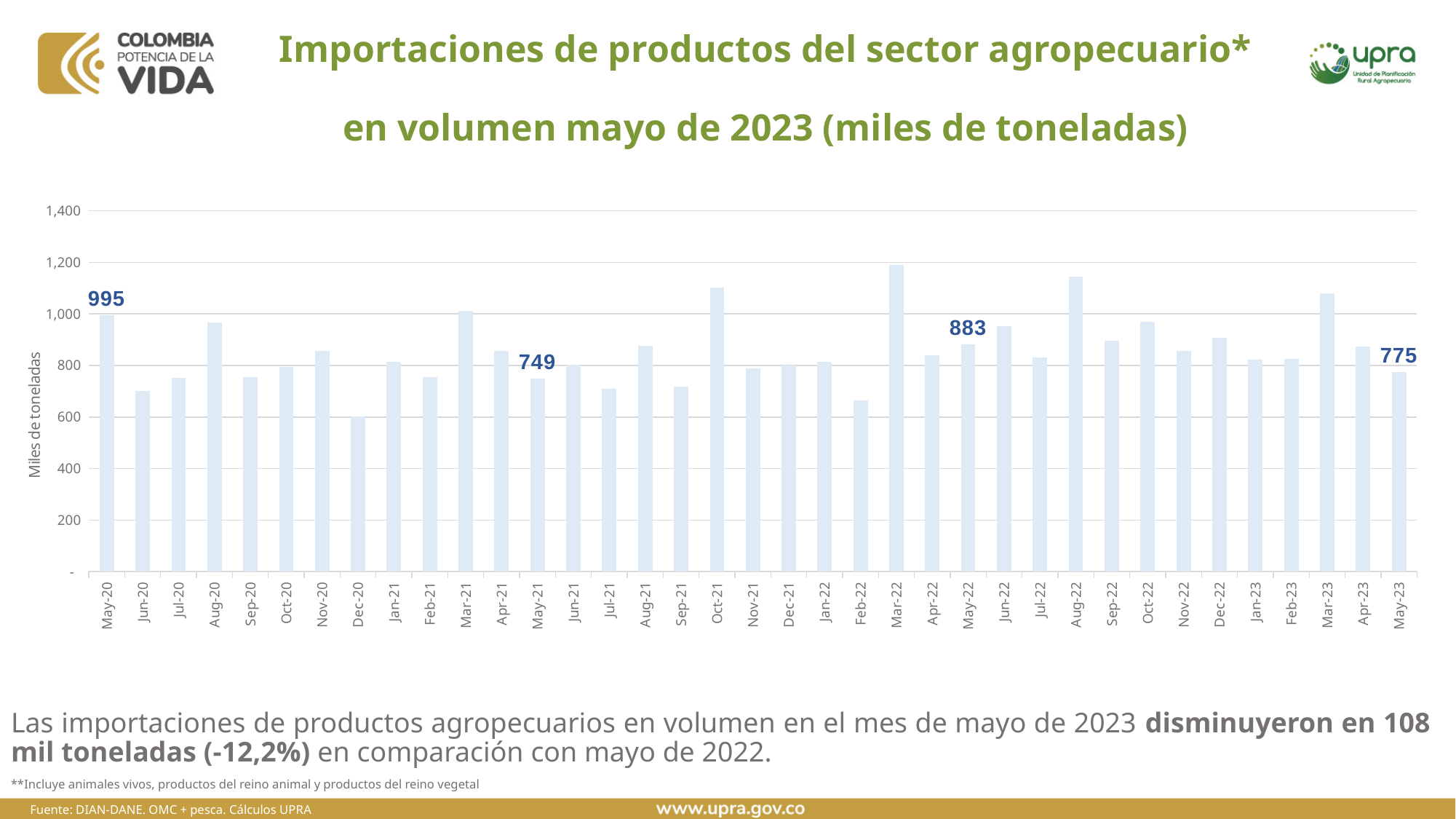
What kind of chart is shown on the slide? Bar chart What is the difference between the values for May-22 and May-23? 108 What is the value for May-22? 883 Is the value for Oct-21 greater or less than 1,000? greater How many monthly bars are plotted in the chart? 37 What is the value for May-21? 749 What is the value for May-20? 995 Which month has the highest bar? Mar-22 Which is larger, the value for May-20 or the value for May-23? May-20 What is the value for May-23? 775 What is the difference between the values for May-20 and May-23? 220 Which month has the lowest bar? Dec-20